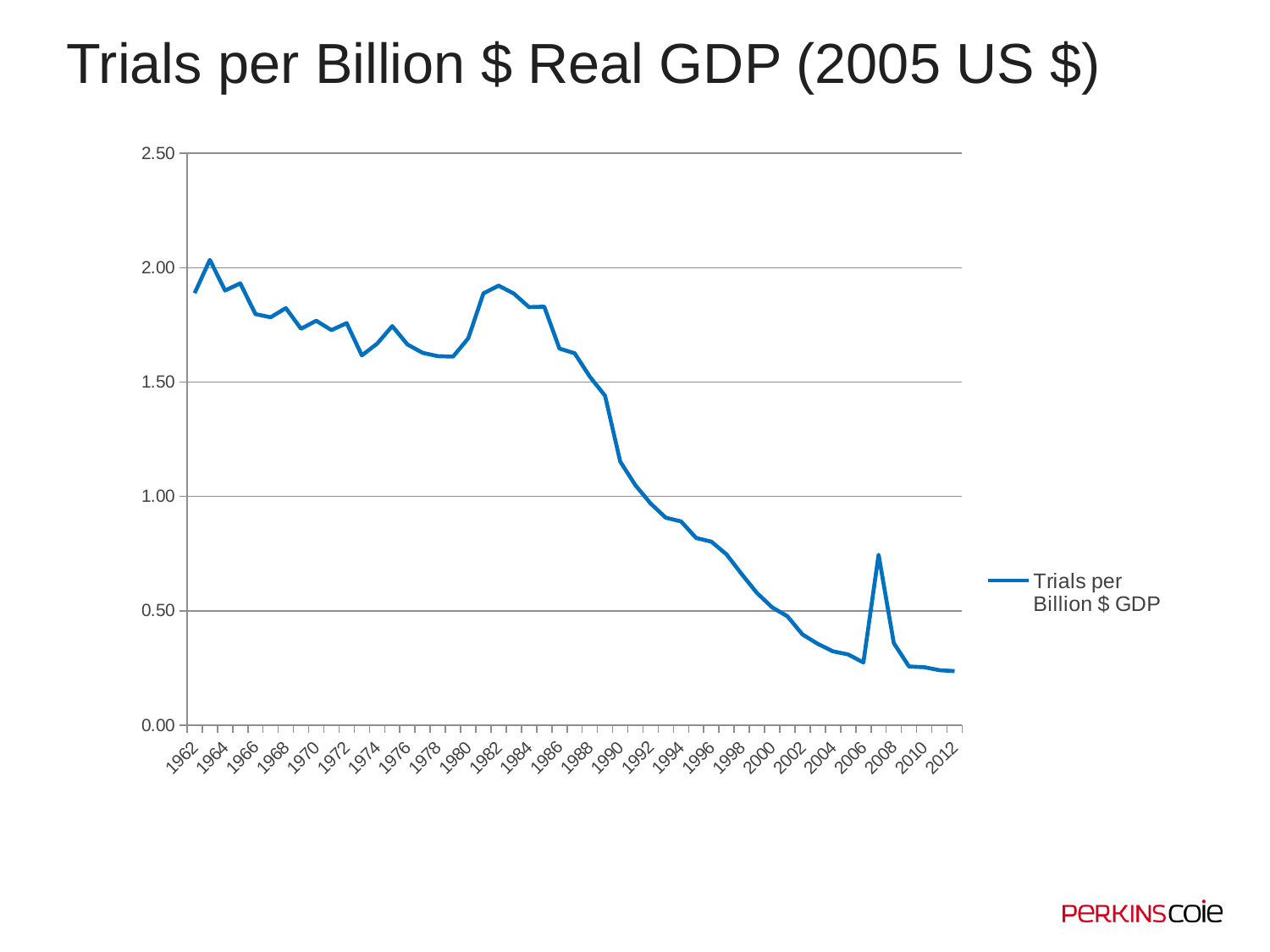
Is the value for 1962 greater or less than 1.50? greater What is the legend entry for the plotted line? Trials per Billion $ GDP Is the value for 1982 greater or less than 1.50? greater Is the value for 1992 greater or less than 1.50? less How many series does the legend list? 1 What kind of chart is shown on the slide? line chart What is the title of the chart? Trials per Billion $ Real GDP (2005 US $) Which year has the higher value, 2006 or 2007? 2007 Overall, do the values rise or fall from 1962 to 2012? fall Which year has the higher value, 1963 or 2007? 1963